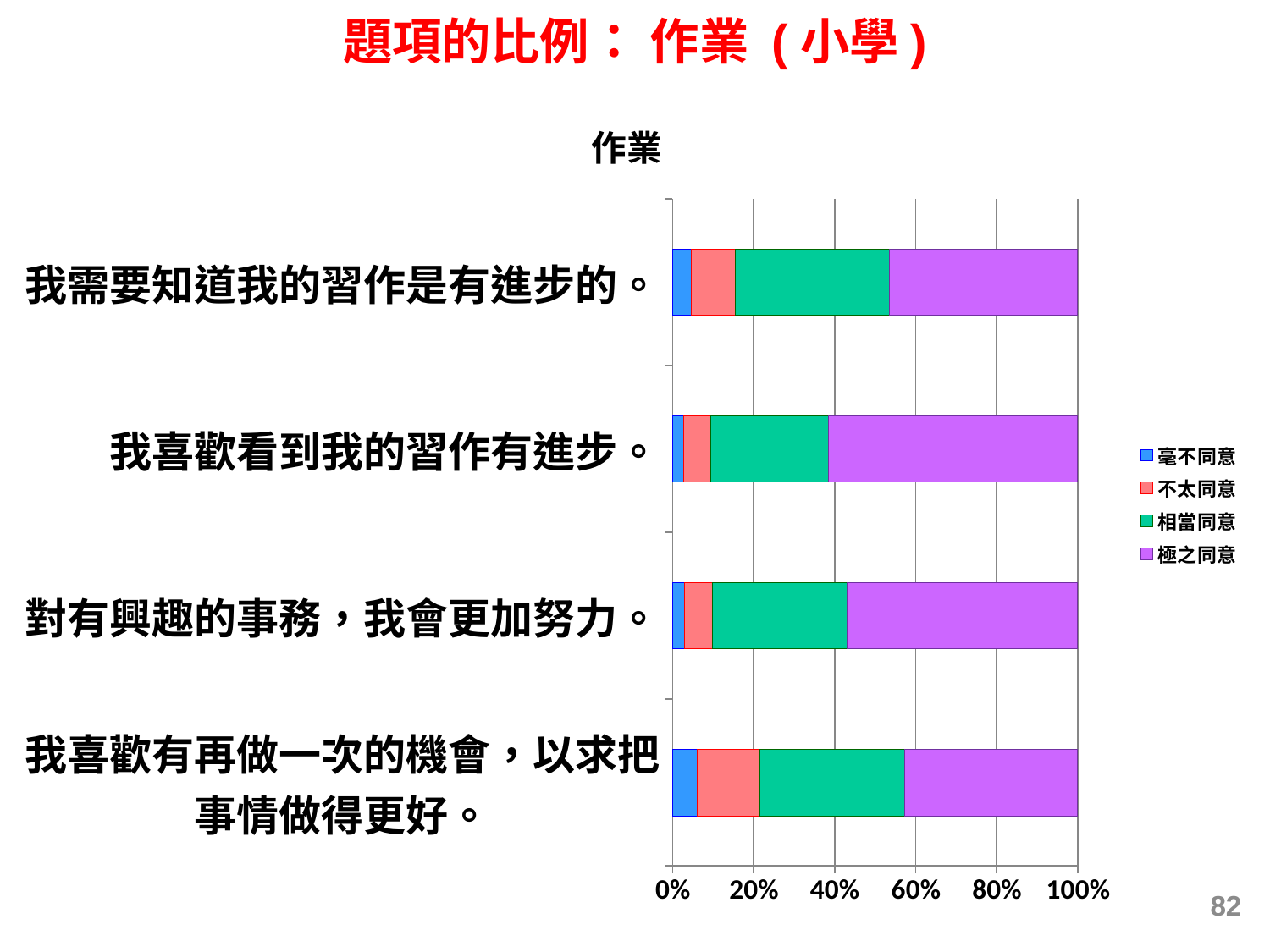
Which statement has the largest 不太同意 segment? 我喜歡有再做一次的機會，以求把事情做得更好。 Is the 毫不同意 value for 我喜歡有再做一次的機會，以求把事情做得更好。 greater or less than 20%? less How many categories (statements) are plotted in the chart? 4 Which legend entry is shown in purple? 極之同意 Is the 相當同意 segment larger for 我需要知道我的習作是有進步的。 or for 我喜歡看到我的習作有進步。? 我需要知道我的習作是有進步的。 How many series does the legend list? 4 Which statement has the largest 極之同意 segment? 我喜歡看到我的習作有進步。 What is the total of the stacked bar for 對有興趣的事務，我會更加努力。? 100% What is the title of the chart? 作業 What kind of chart is shown on the slide? bar chart Is the 極之同意 value for 我需要知道我的習作是有進步的。 greater or less than 40%? greater Which statement has the smallest 相當同意 segment? 我喜歡看到我的習作有進步。